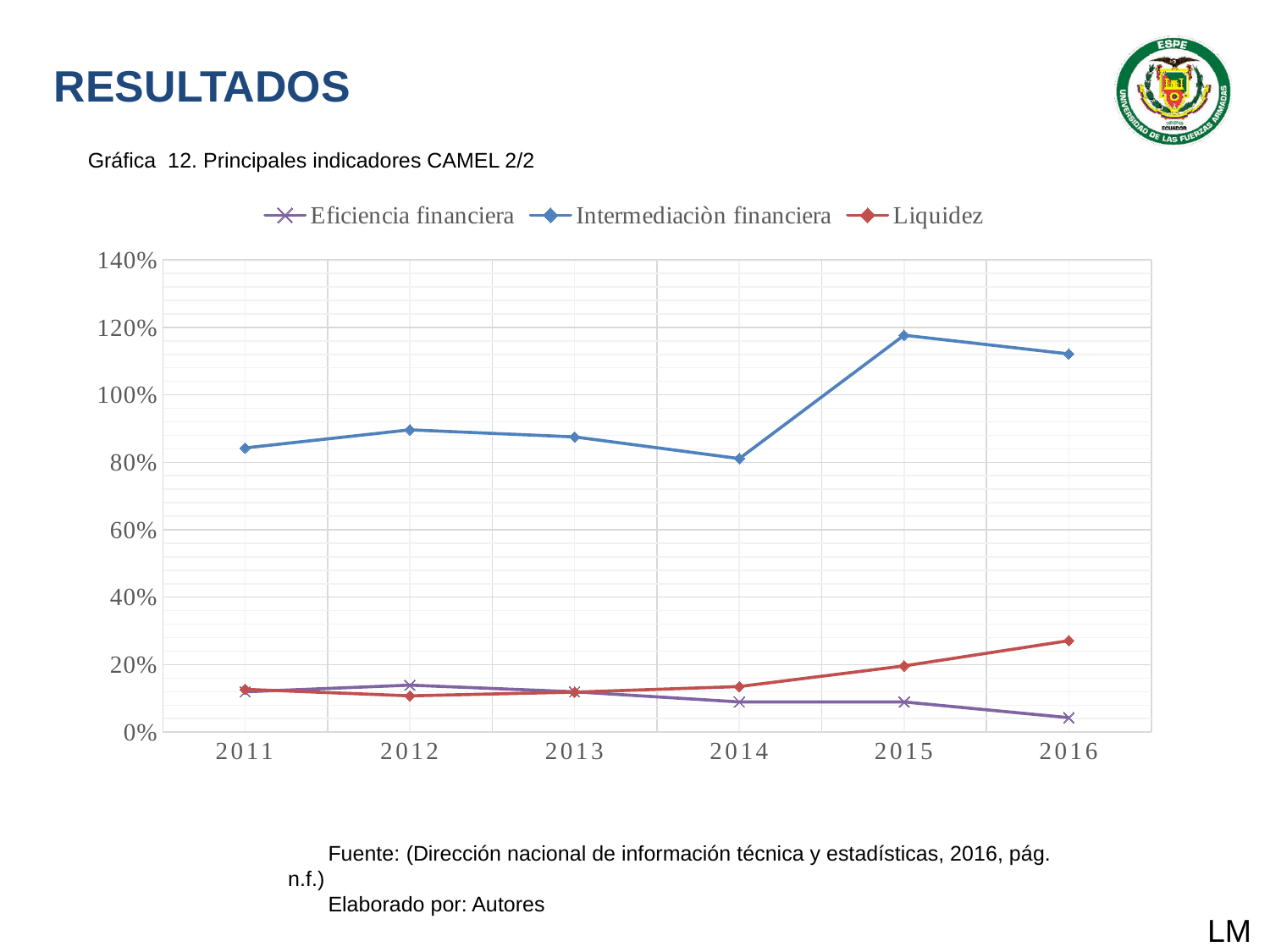
Which is larger in 2016, Liquidez or Eficiencia financiera? Liquidez In which year is Intermediaciòn financiera lowest? 2014 Is the value for Liquidez in 2016 greater or less than 40%? less What kind of chart is shown on the slide? line chart In which year is Liquidez highest? 2016 What is the title of the chart given above it? Gráfica 12. Principales indicadores CAMEL 2/2 In which year is Eficiencia financiera lowest? 2016 In which year is Intermediaciòn financiera highest? 2015 Is the value for Intermediaciòn financiera in 2015 greater or less than 100%? greater How many series does the legend list? 3 Does Liquidez rise or fall from 2013 to 2016? rise How many years are plotted along the x axis? 6